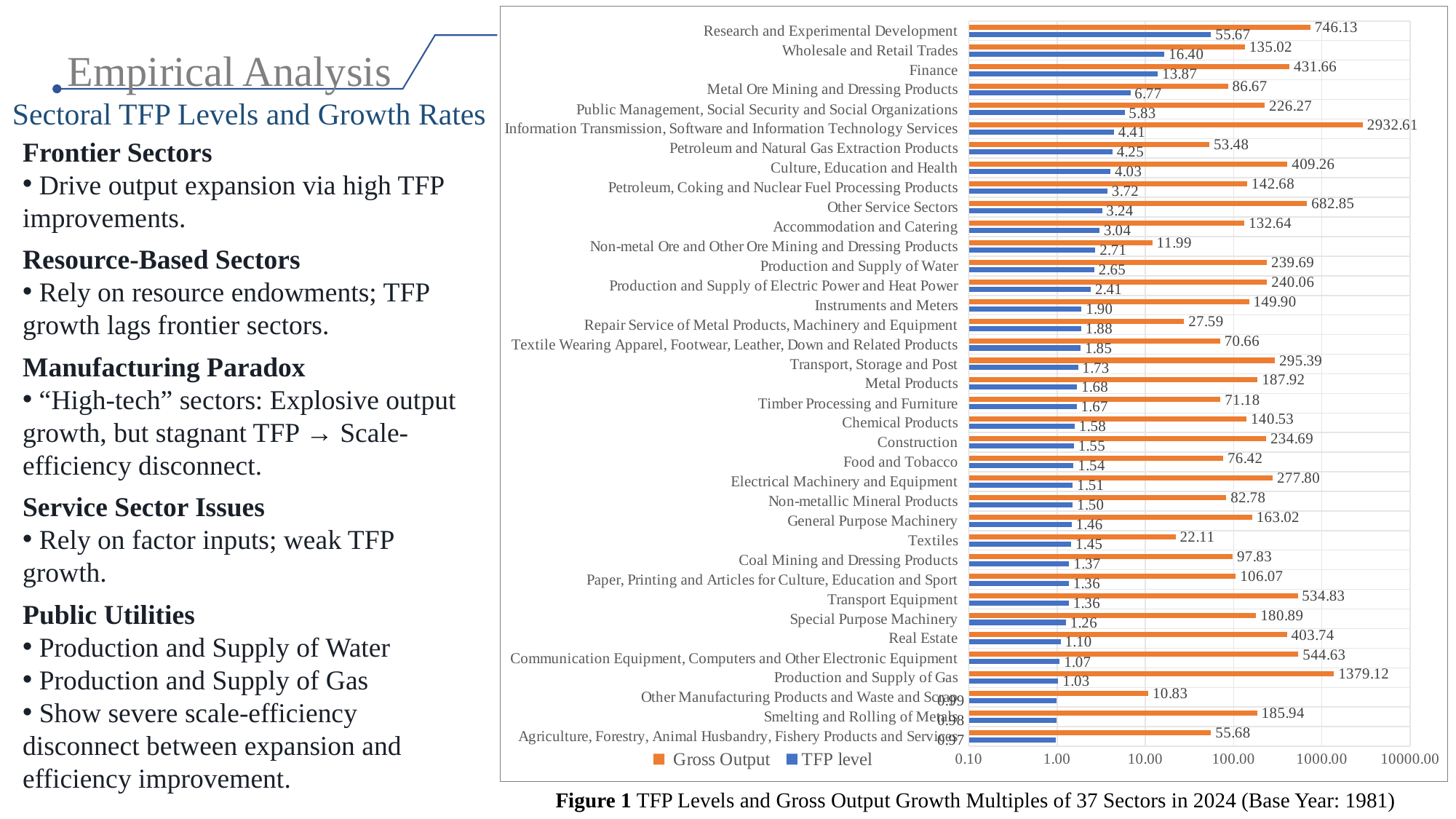
Which sector has the lowest Gross Output value? Other Manufacturing Products and Waste and Scrap Which has the larger Gross Output value, Transport Equipment or Real Estate? Transport Equipment What is the Gross Output value for Information Transmission, Software and Information Technology Services? 2932.61 Which sector has the highest Gross Output value? Information Transmission, Software and Information Technology Services What kind of chart is shown on the slide? Bar chart What is the TFP level for Research and Experimental Development? 55.67 Is the TFP level for Finance greater or less than 10.00? greater What is the Gross Output value for Finance? 431.66 Which sector has the highest TFP level? Research and Experimental Development How many sectors are shown in the chart? 37 What is the difference between the Gross Output values for Research and Experimental Development and Wholesale and Retail Trades? 611.11 How many series does the legend list? 2